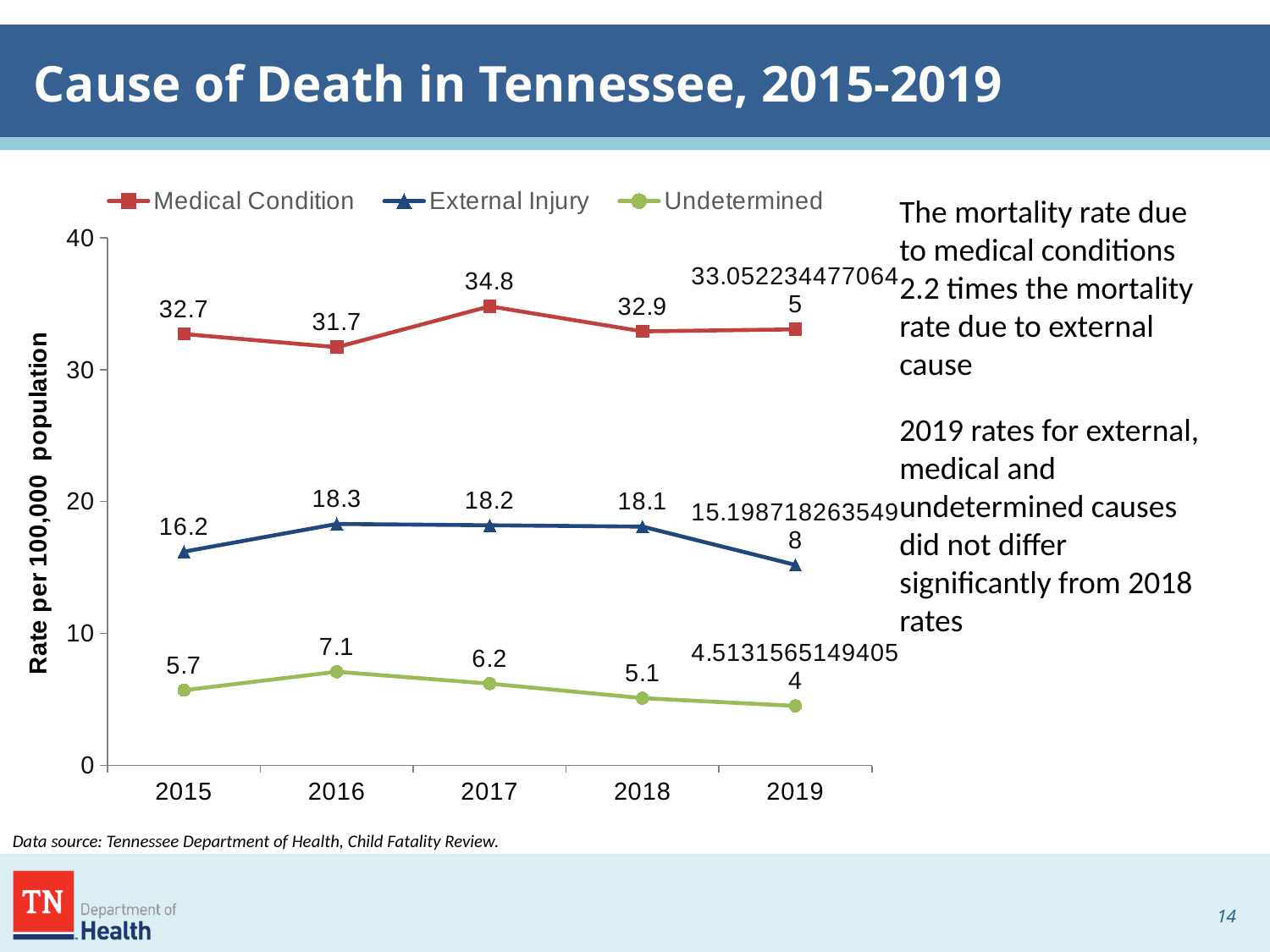
How much higher is the Medical Condition rate in 2017 than in 2016? 3.1 What is the Undetermined rate in 2016? 7.1 How many series does the legend list? 3 In which year is the Undetermined rate lowest? 2019 In which year is the Medical Condition rate highest? 2017 What kind of chart is shown on the slide? line chart Which year has the higher External Injury rate, 2015 or 2016? 2016 Is the Medical Condition rate in 2019 greater or less than 30? greater What is the Medical Condition rate in 2017? 34.8 What is the External Injury rate in 2015? 16.2 How many years are shown on the x axis? 5 Does the Undetermined rate rise or fall from 2016 to 2019? fall